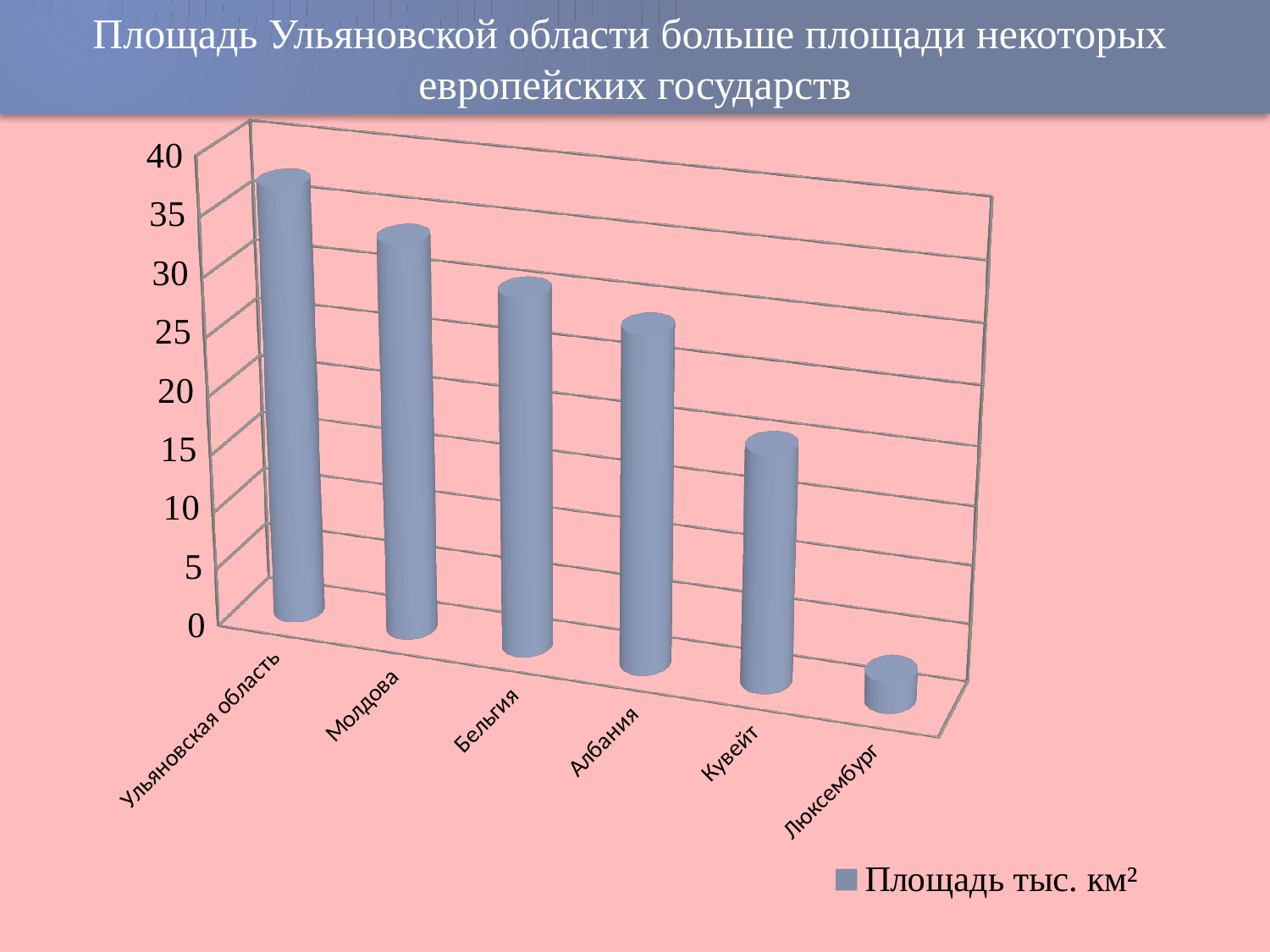
Which category has the highest value in the chart? Ульяновская область Which is larger, the value for Бельгия or the value for Люксембург? Бельгия What kind of chart is shown on the slide? bar chart Is the value for Кувейт greater or less than 25? less Do the values rise or fall from left to right along the x axis? fall What series name is shown in the chart legend? Площадь тыс. км² How many series does the legend list? 1 Is the value for Люксембург greater or less than 5? less Which is larger, the value for Ульяновская область or the value for Кувейт? Ульяновская область Is the value for Ульяновская область greater or less than 30? greater How many categories are plotted in the chart? 6 Which category has the lowest value in the chart? Люксембург